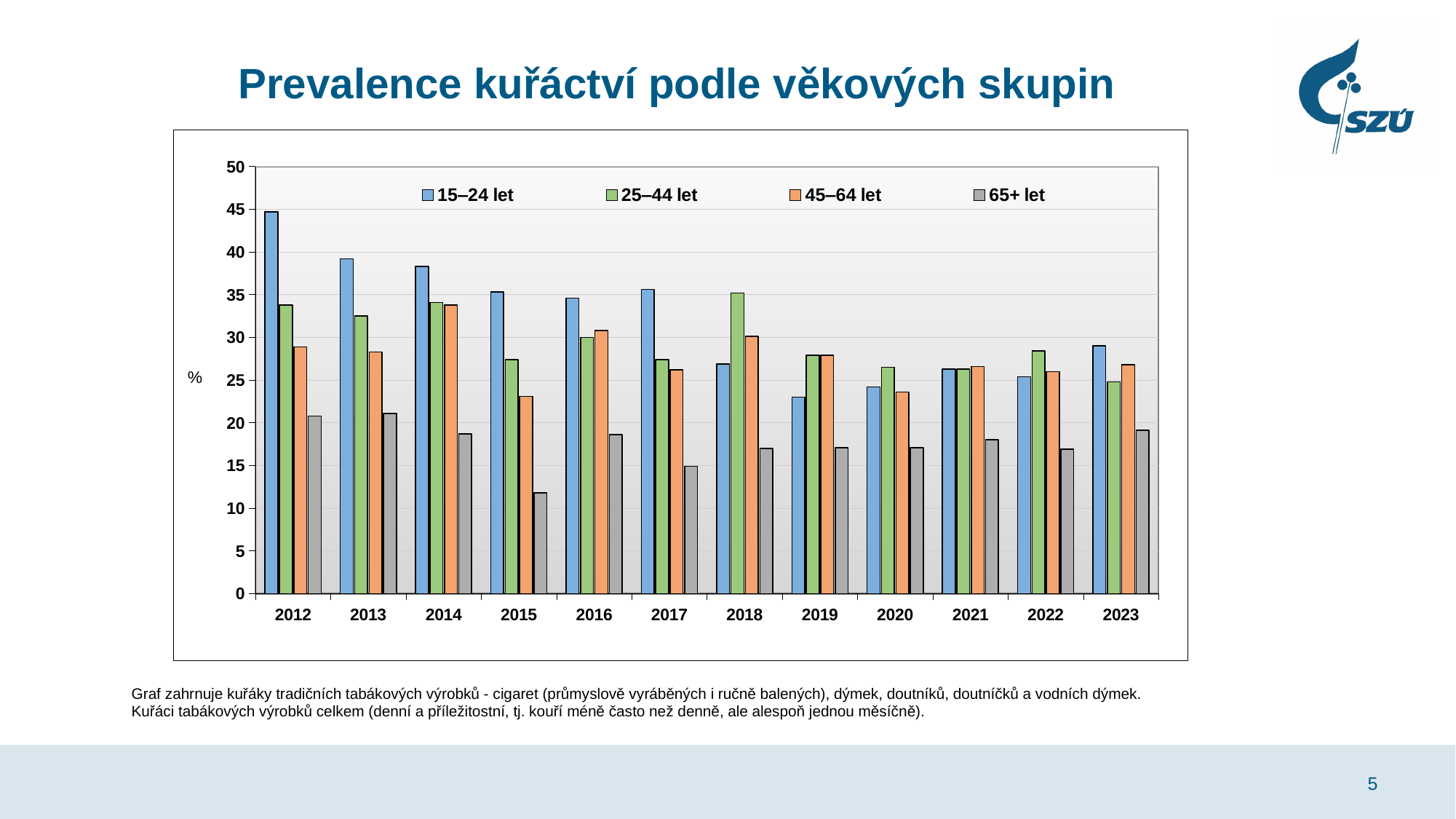
Is the value for 15–24 let in 2012 greater or less than 40? greater What unit is shown on the y axis label? % Do the values for 15–24 let generally rise or fall from 2012 to 2019? fall How many series does the legend list? 4 In 2018, which age group has the larger value: 15–24 let or 25–44 let? 25–44 let In which year is the bar for 65+ let the lowest? 2015 What kind of chart is shown on the slide? bar chart How many years are shown on the x axis? 12 Is the value for 25–44 let in 2018 greater or less than 30? greater In which year is the bar for 15–24 let the highest? 2012 Is the value for 65+ let in 2015 greater or less than 15? less In 2012, which age group has the larger value: 15–24 let or 65+ let? 15–24 let